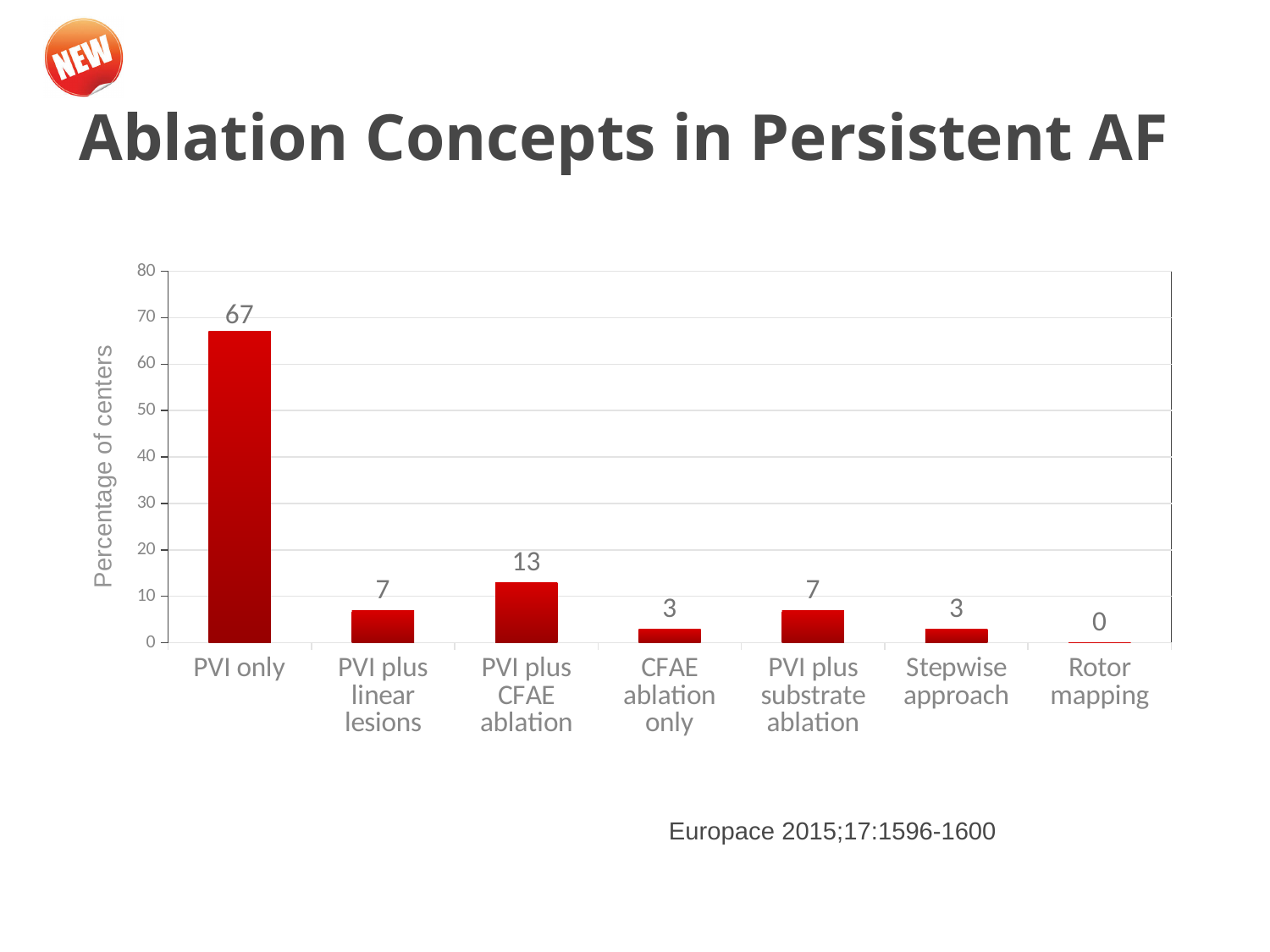
What is the value for Rotor mapping? 0 How many ablation concepts are shown on the x axis? 7 Which is larger, the value for PVI plus linear lesions or the value for CFAE ablation only? PVI plus linear lesions Which ablation concept has the highest percentage of centers? PVI only Which ablation concept has the lowest percentage of centers? Rotor mapping What percentage of centers use PVI only? 67 What is the value for PVI plus CFAE ablation? 13 What is the label of the vertical axis? Percentage of centers What is the difference between the values for PVI only and PVI plus CFAE ablation? 54 What kind of chart is shown on the slide? Bar chart What is the value for Stepwise approach? 3 Is the value for PVI only greater or less than 60? greater